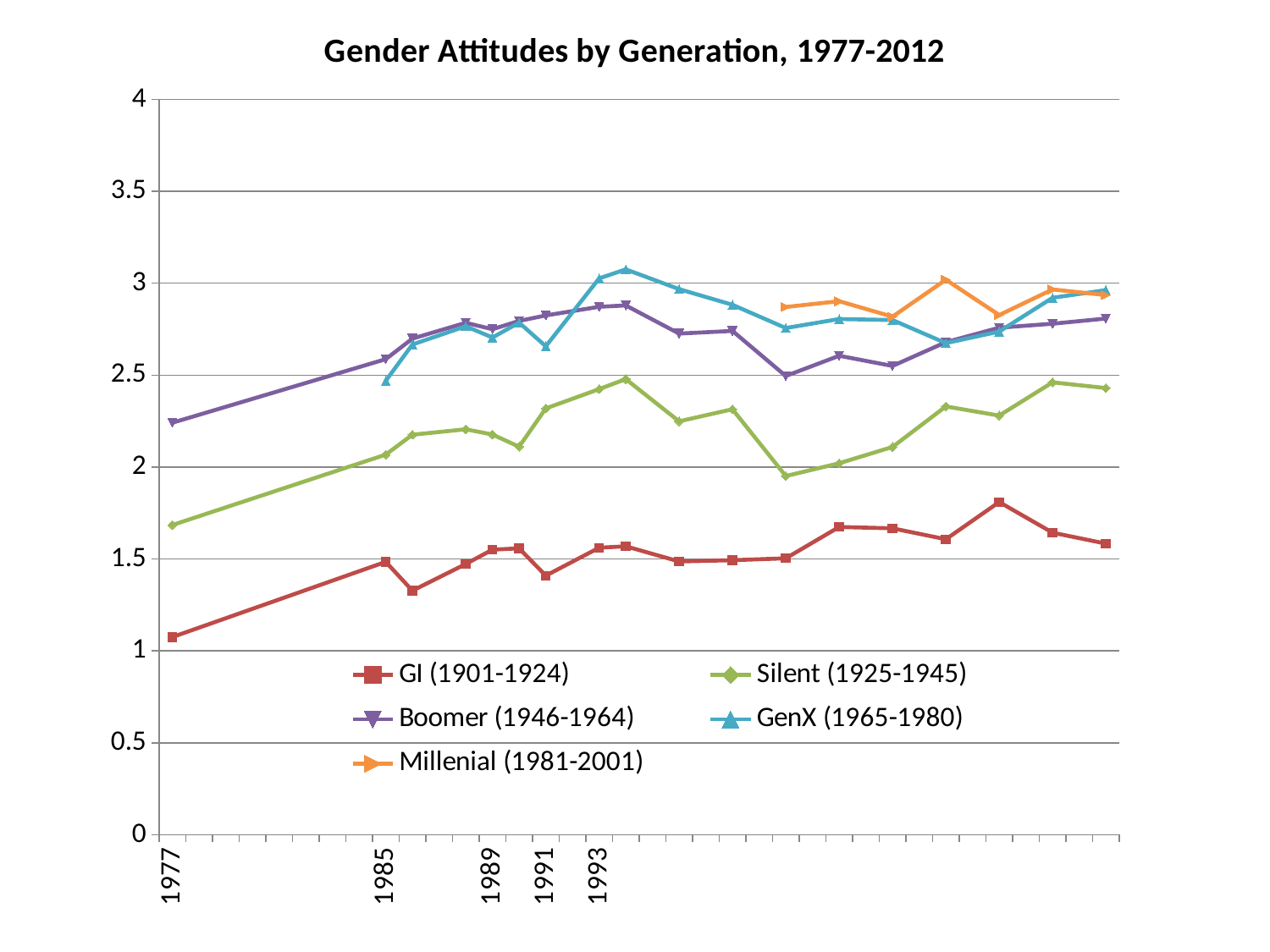
In 1977, which series has the higher value, GI (1901-1924) or Silent (1925-1945)? Silent (1925-1945) Which series has the lowest values throughout the chart? GI (1901-1924) What is the title of the chart? Gender Attitudes by Generation, 1977-2012 Is the value for Boomer (1946-1964) in 1993 greater or less than 2.5? greater Does the GI (1901-1924) line rise or fall between 1977 and 1985? rise What kind of chart is shown on the slide? line chart In 1985, which series has the higher value, Boomer (1946-1964) or Silent (1925-1945)? Boomer (1946-1964) Is the value for Boomer (1946-1964) in 1977 greater or less than 2? greater Which series is drawn in orange? Millenial (1981-2001) Is the value for GI (1901-1924) in 1977 greater or less than 1.5? less How many series does the legend list? 5